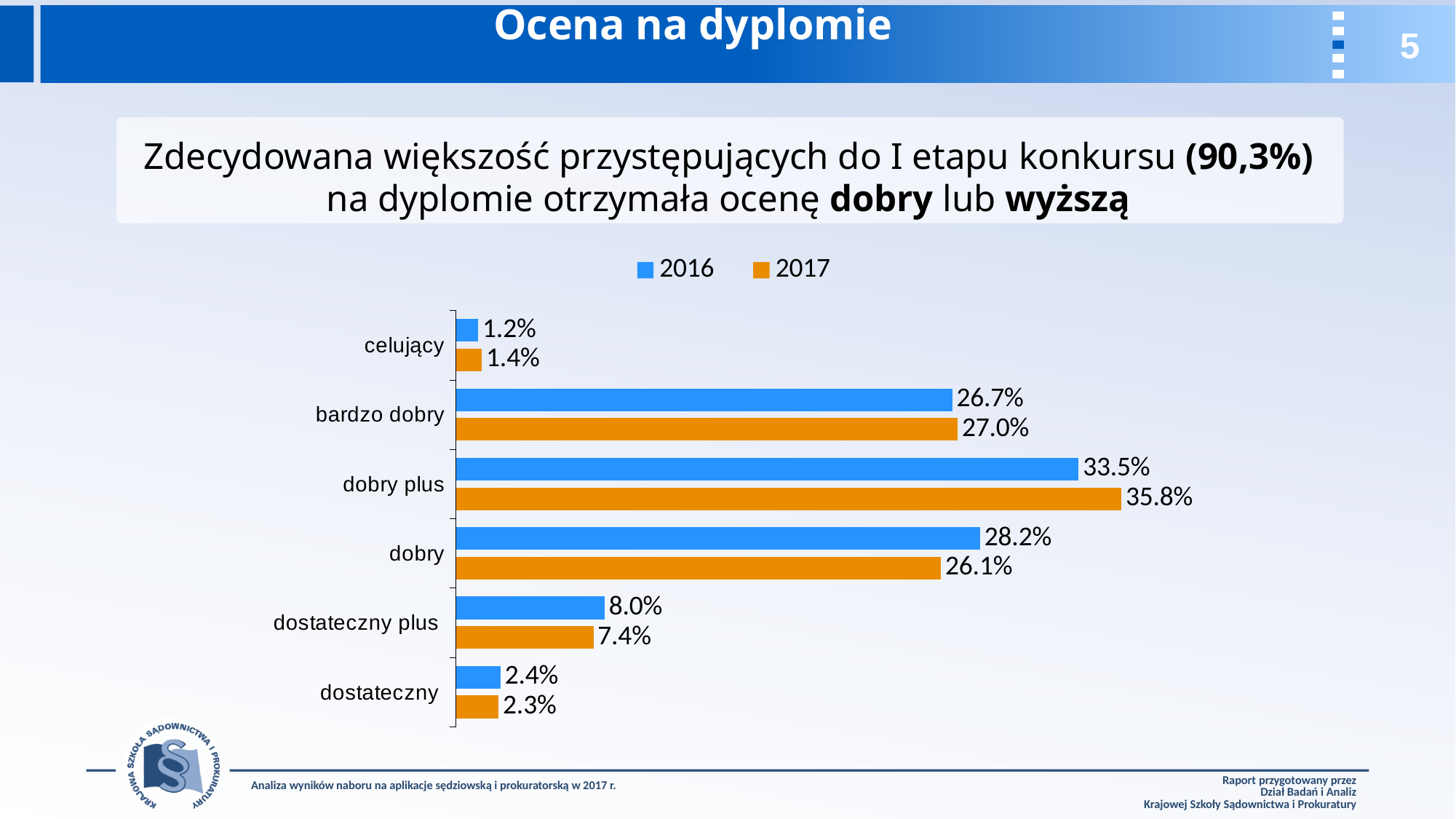
How many grade categories are shown on the chart? 6 What is the value for 'bardzo dobry' in the 2016 series? 26.7% What is the difference between the 2017 and 2016 values for 'dobry plus'? 2.3% How many series does the legend list? 2 Which colour represents the 2017 series in the chart? orange Which category has the lowest value in the 2017 series? celujący What is the value for 'dobry plus' in the 2017 series? 35.8% For 'dobry', which series has the larger value, 2016 or 2017? 2016 What is the value for 'dostateczny plus' in the 2017 series? 7.4% What is the difference between the 2016 and 2017 values for 'dobry'? 2.1% What kind of chart is shown on the slide? bar chart Which category has the highest value in the 2016 series? dobry plus